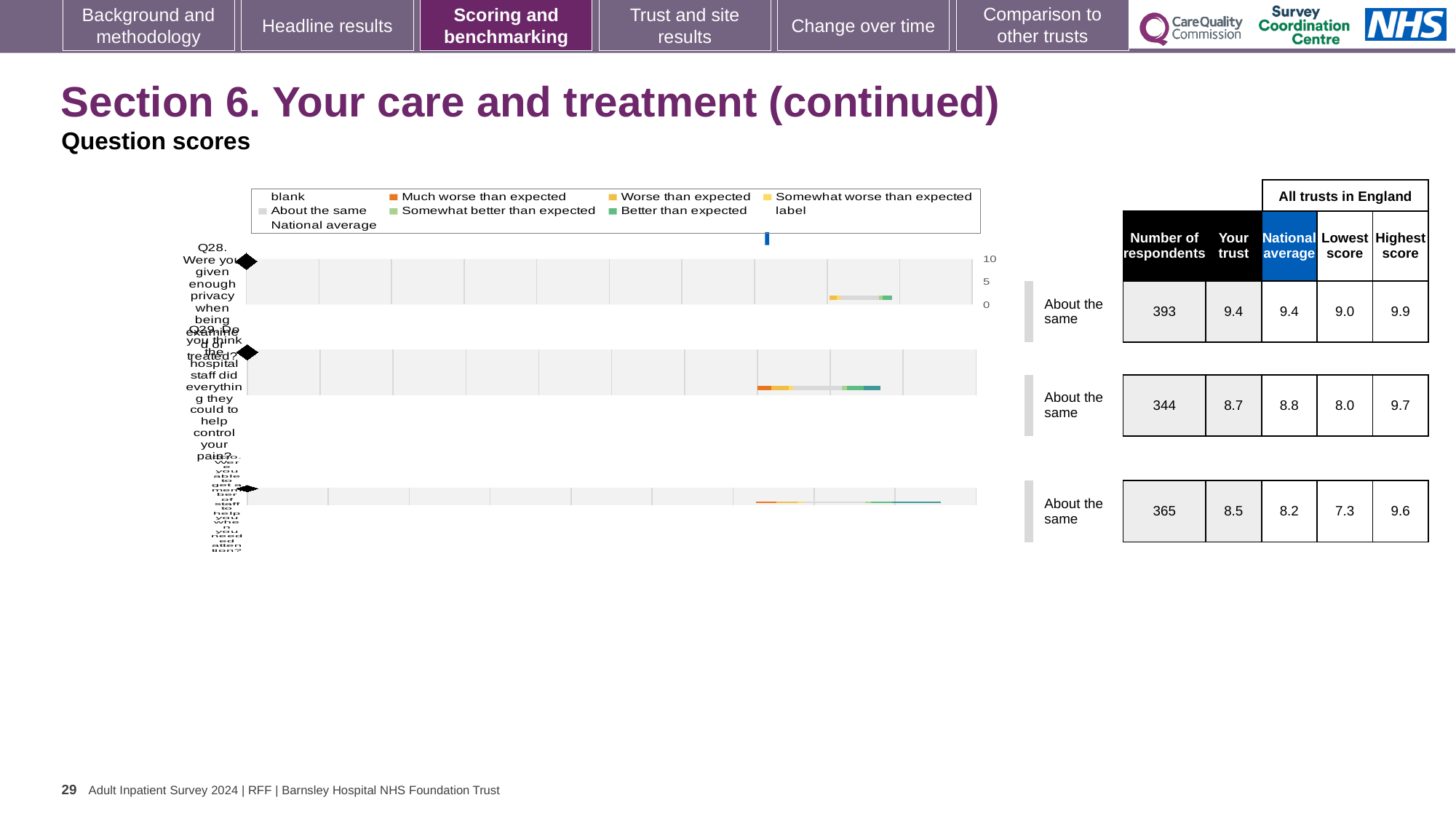
How many respondents answered Q30 (Were you able to get a member of staff to help you when you needed attention?)? 365 What is the highest score across all trusts in England for Q29? 9.7 What is the national average score for Q29 (Do you think the hospital staff did everything they could to help control your pain?)? 8.8 Which question has the lowest 'Lowest score' value across all trusts in England? Q30 For Q29, which is larger: the 'Your trust' score or the national average? National average For Q30, what is the difference between the 'Your trust' score and the national average? 0.3 How many survey questions are plotted on this slide? 3 What kind of chart is used to show the question scores on this slide? Bar chart For Q28, what is the difference between the highest score and the lowest score across all trusts in England? 0.9 What benchmarking category is shown for Q28? About the same What is the 'Your trust' score for Q28 (Were you given enough privacy when being examined or treated?)? 9.4 Which question has the highest 'Your trust' score on this slide? Q28